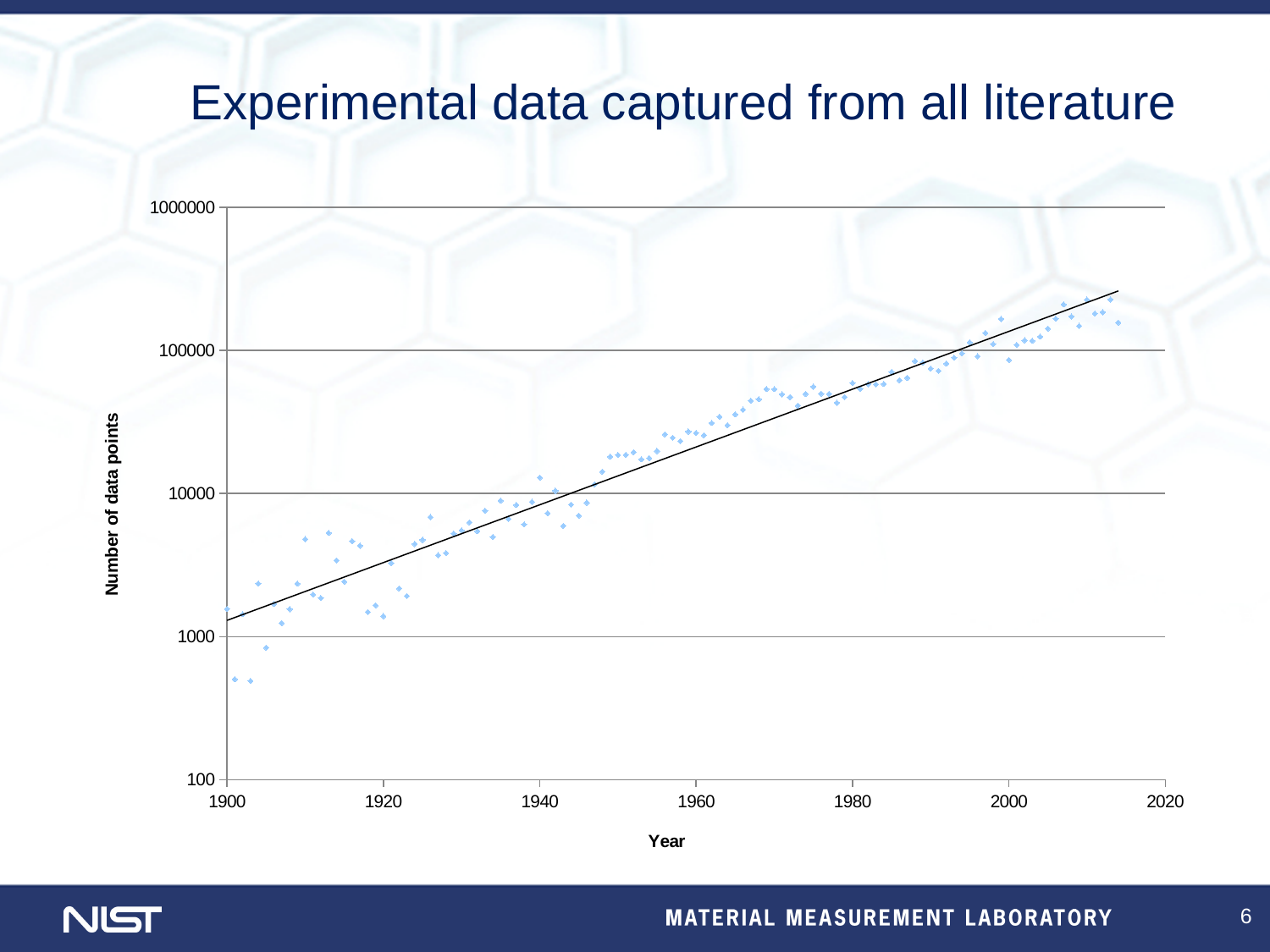
Do the plotted values generally rise or fall as the year increases from 1900 to 2020? rise Is the value for 1980 greater or less than 100000? less Which is larger, the value for 1940 or the value for 1970? 1970 Is the value for 2010 greater or less than 100000? greater Is the value for 1900 greater or less than 10000? less Which is larger, the value for 1920 or the value for 2000? 2000 What kind of chart is shown on the slide? scatter chart What is the title of the chart on the slide? Experimental data captured from all literature What is the label of the vertical axis? Number of data points